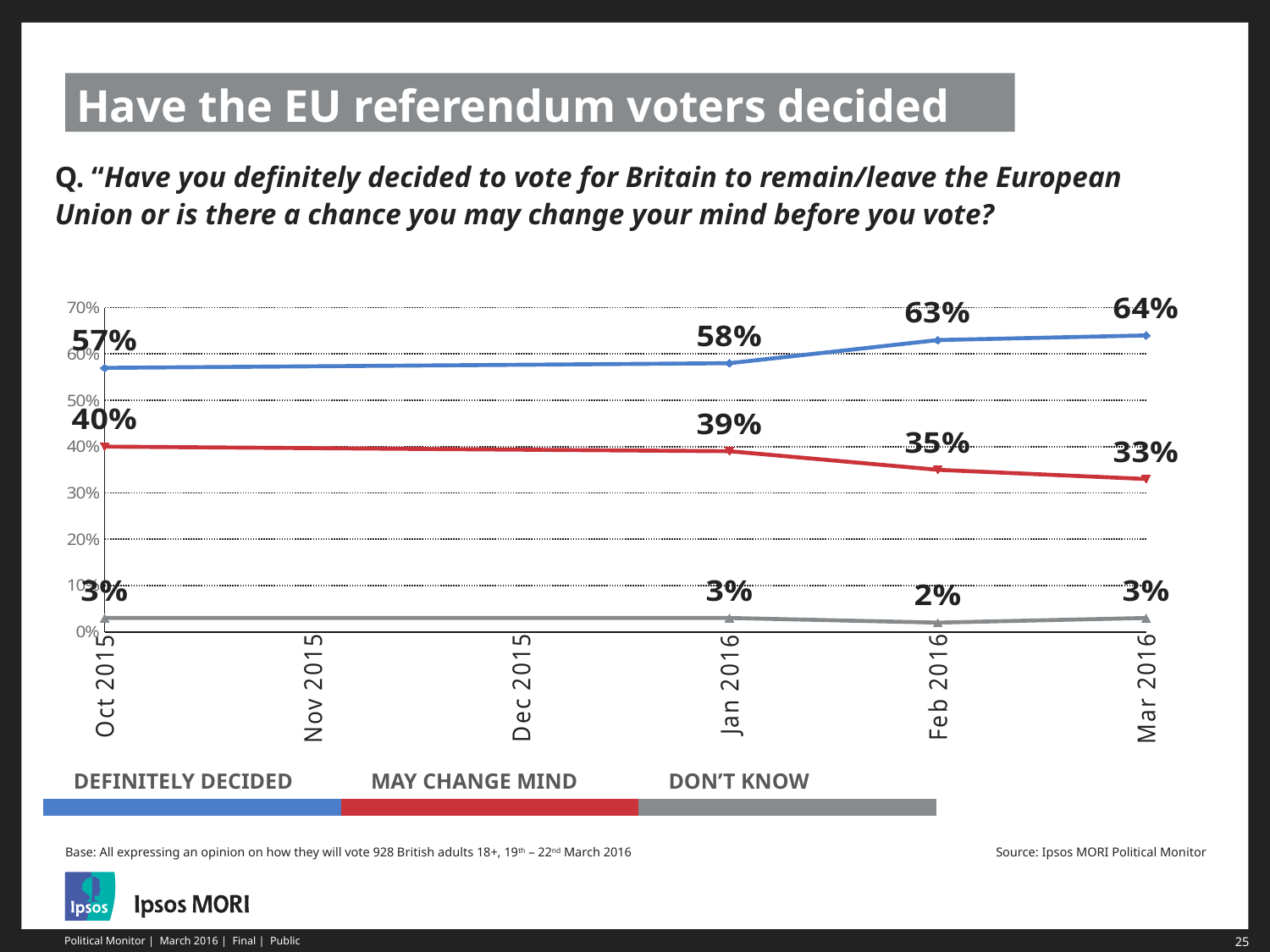
Which colour is used for the Don't Know series? grey What is the value for Don't Know in Feb 2016? 2% In which month is the May Change Mind value lowest? Mar 2016 In which month is the Definitely Decided value highest? Mar 2016 Which is larger in Jan 2016: Definitely Decided or May Change Mind? Definitely Decided What is the value for Definitely Decided in Mar 2016? 64% How many series does the legend list? 3 What is the value for Definitely Decided in Oct 2015? 57% What is the value for May Change Mind in Feb 2016? 35% What is the difference between the Definitely Decided value in Mar 2016 and in Oct 2015? 7% Does the May Change Mind series rise or fall from Oct 2015 to Mar 2016? fall What type of chart is shown on the slide? line chart